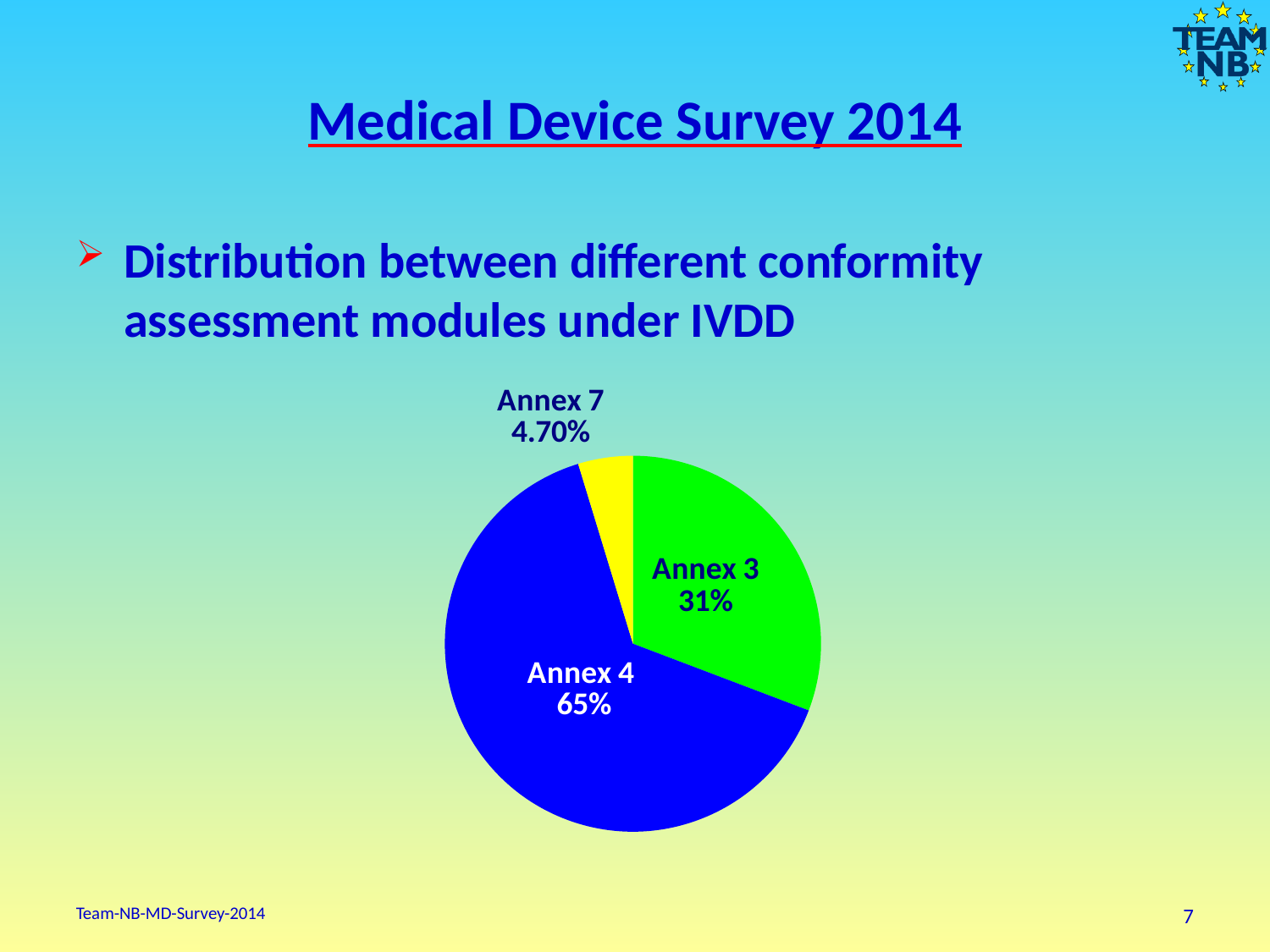
What share of the pie does Annex 7 represent? 4.70% Which is larger, the share for Annex 3 or the share for Annex 7? Annex 3 What colour is the Annex 7 slice? yellow What share of the pie does Annex 4 represent? 65% What share of the pie does Annex 3 represent? 31% What colour is the Annex 4 slice? blue Which annex has the largest share of the pie? Annex 4 What kind of chart is shown on the slide? pie chart Which annex has the smallest share of the pie? Annex 7 What is the difference in percentage points between the Annex 4 share and the Annex 3 share? 34 How many slices does the pie chart have? 3